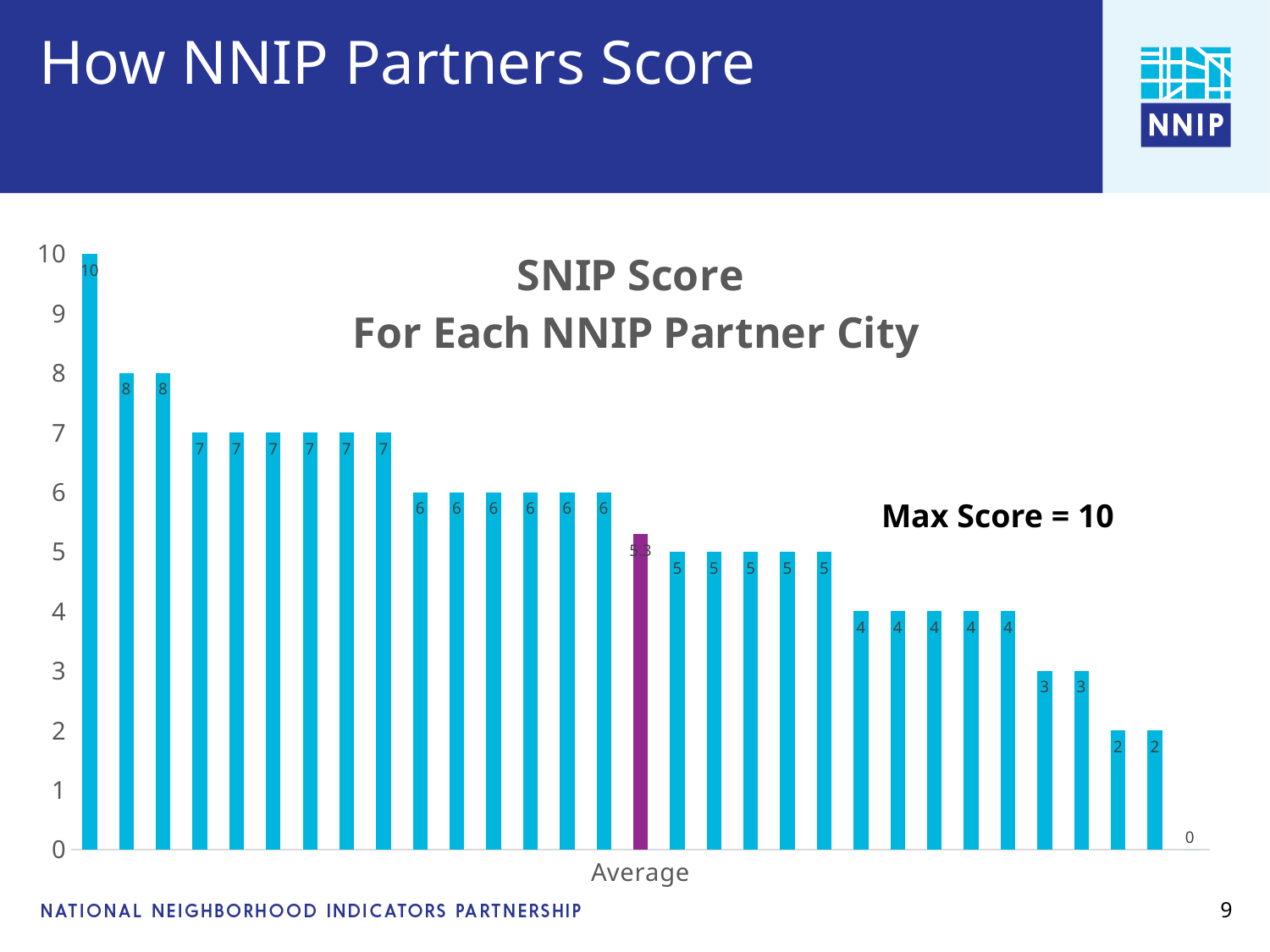
What is the value of the Average bar? 5.3 How many bars have a score of 4? 5 What is the lowest score shown on the chart? 0 What colour is the Average bar? purple What kind of chart is shown on the slide? bar chart Is the Average score larger or smaller than the scores of 5 to its right? larger What is the difference between the highest score and the Average score? 4.7 What is the title of the chart? SNIP Score For Each NNIP Partner City What is the highest score shown on the chart? 10 Do the scores rise or fall from left to right across the chart? fall How many bars have a score of 7? 6 According to the annotation on the chart, what is the maximum possible score? 10